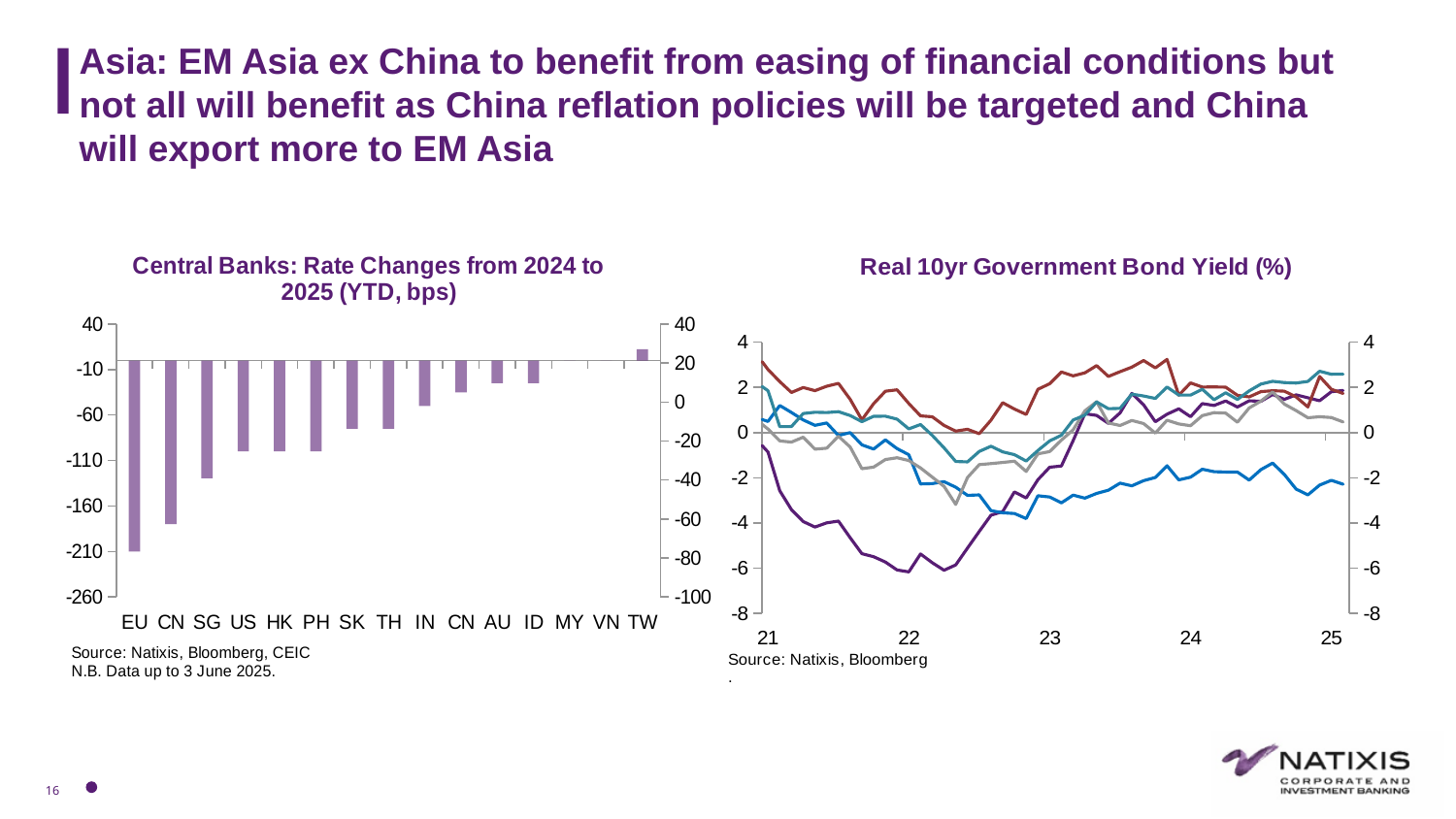
In the 'Central Banks: Rate Changes from 2024 to 2025 (YTD, bps)' chart, which category has the highest value? TW What kind of chart is the 'Real 10yr Government Bond Yield (%)' chart? Line chart In the 'Real 10yr Government Bond Yield (%)' chart, is the value of the blue line at 25 greater or less than 0? less What kind of chart is the 'Central Banks: Rate Changes from 2024 to 2025 (YTD, bps)' chart? Bar chart In the 'Real 10yr Government Bond Yield (%)' chart, is the value of the red line at 25 greater or less than 0? greater In the 'Real 10yr Government Bond Yield (%)' chart, does the purple line rise or fall between 21 and 22 on the x axis? Fall What is the source given under the 'Real 10yr Government Bond Yield (%)' chart? Natixis, Bloomberg In the 'Central Banks: Rate Changes from 2024 to 2025 (YTD, bps)' chart, which bar is more negative, IN or AU? IN In the 'Central Banks: Rate Changes from 2024 to 2025 (YTD, bps)' chart, which category has the lowest (most negative) value? EU In the 'Central Banks: Rate Changes from 2024 to 2025 (YTD, bps)' chart, how many categories are shown on the x axis? 15 In the 'Real 10yr Government Bond Yield (%)' chart, which coloured line reaches the lowest value on the chart? Purple In the 'Central Banks: Rate Changes from 2024 to 2025 (YTD, bps)' chart, which bar is more negative, EU or SG? EU